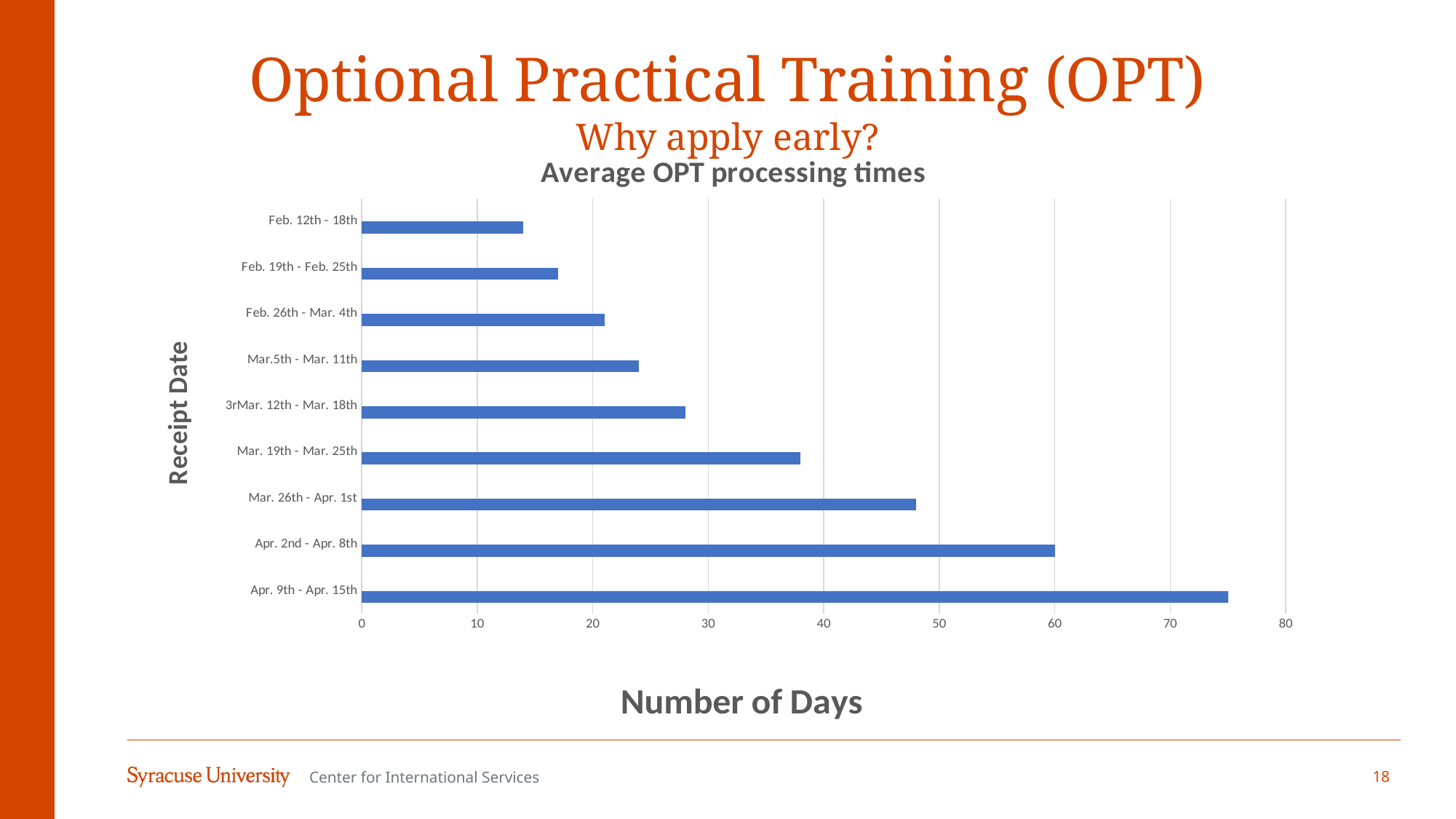
Is the value for Mar. 26th - Apr. 1st greater or less than 50? less What is the title of the chart? Average OPT processing times Which receipt date has the longest average processing time? Apr. 9th - Apr. 15th How many receipt date categories are plotted in the chart? 9 What type of chart is shown on the slide? Bar chart Is the value for Apr. 9th - Apr. 15th greater or less than 70? greater What is the label of the horizontal axis? Number of Days Which has a longer average processing time, Apr. 2nd - Apr. 8th or Mar. 19th - Mar. 25th? Apr. 2nd - Apr. 8th Is the value for Feb. 12th - 18th greater or less than 20? less Do the average processing times rise or fall as the receipt dates get later (moving down the chart)? Rise Which receipt date has the shortest average processing time? Feb. 12th - 18th